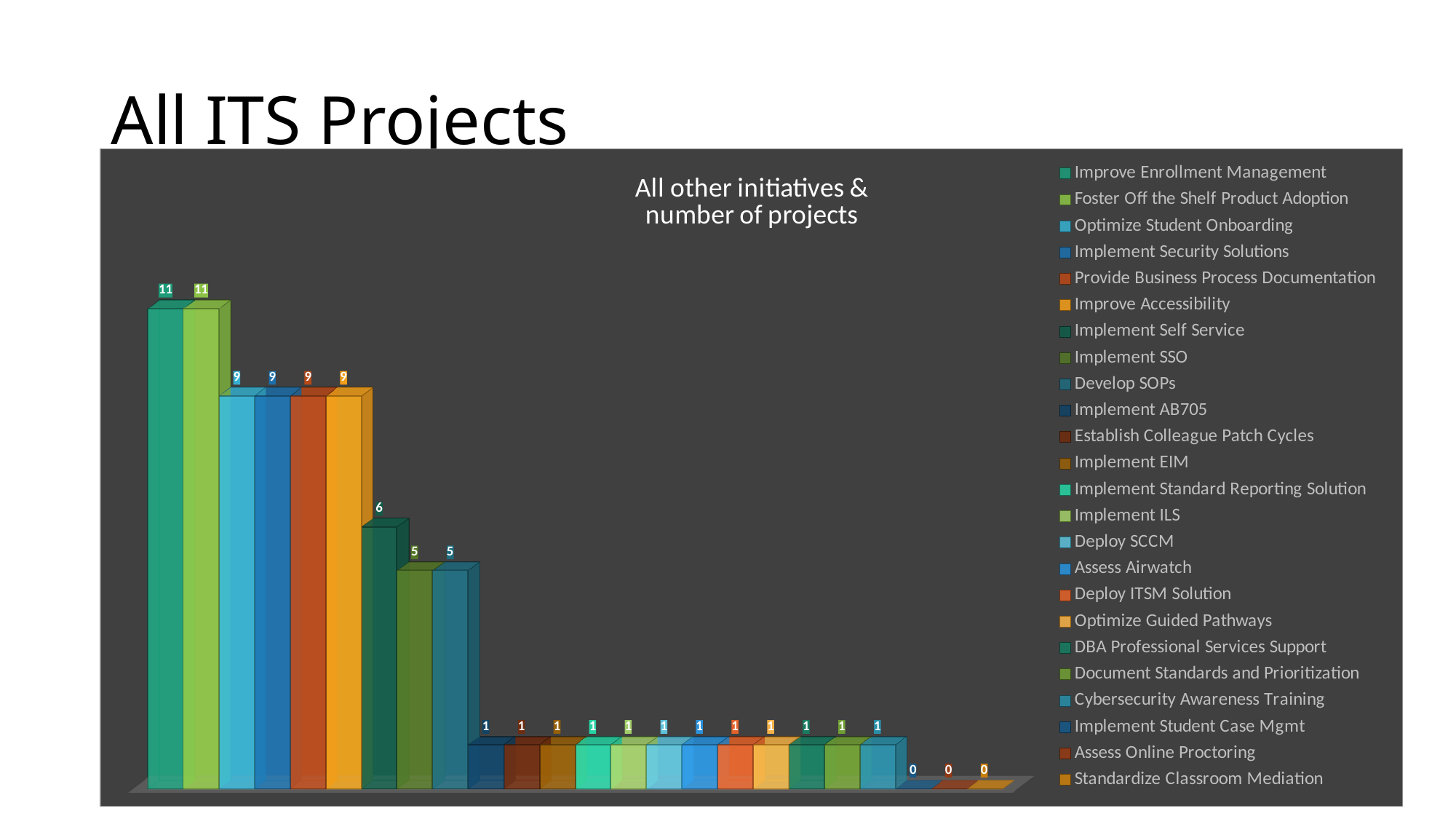
What is the difference between the number of projects for Implement Security Solutions and Implement SSO? 4 Which has more projects, Optimize Student Onboarding or Develop SOPs? Optimize Student Onboarding How many series does the chart legend list? 24 What is the number of projects for Improve Accessibility? 9 What is the highest value shown on the chart? 11 What is the number of projects for Implement SSO? 5 What is the lowest value shown on the chart? 0 What is the number of projects for Implement Self Service? 6 What kind of chart is shown on the slide? Bar chart What is the number of projects for Improve Enrollment Management? 11 What is the title of the chart? All other initiatives & number of projects What is the difference between the number of projects for Improve Enrollment Management and Implement Self Service? 5